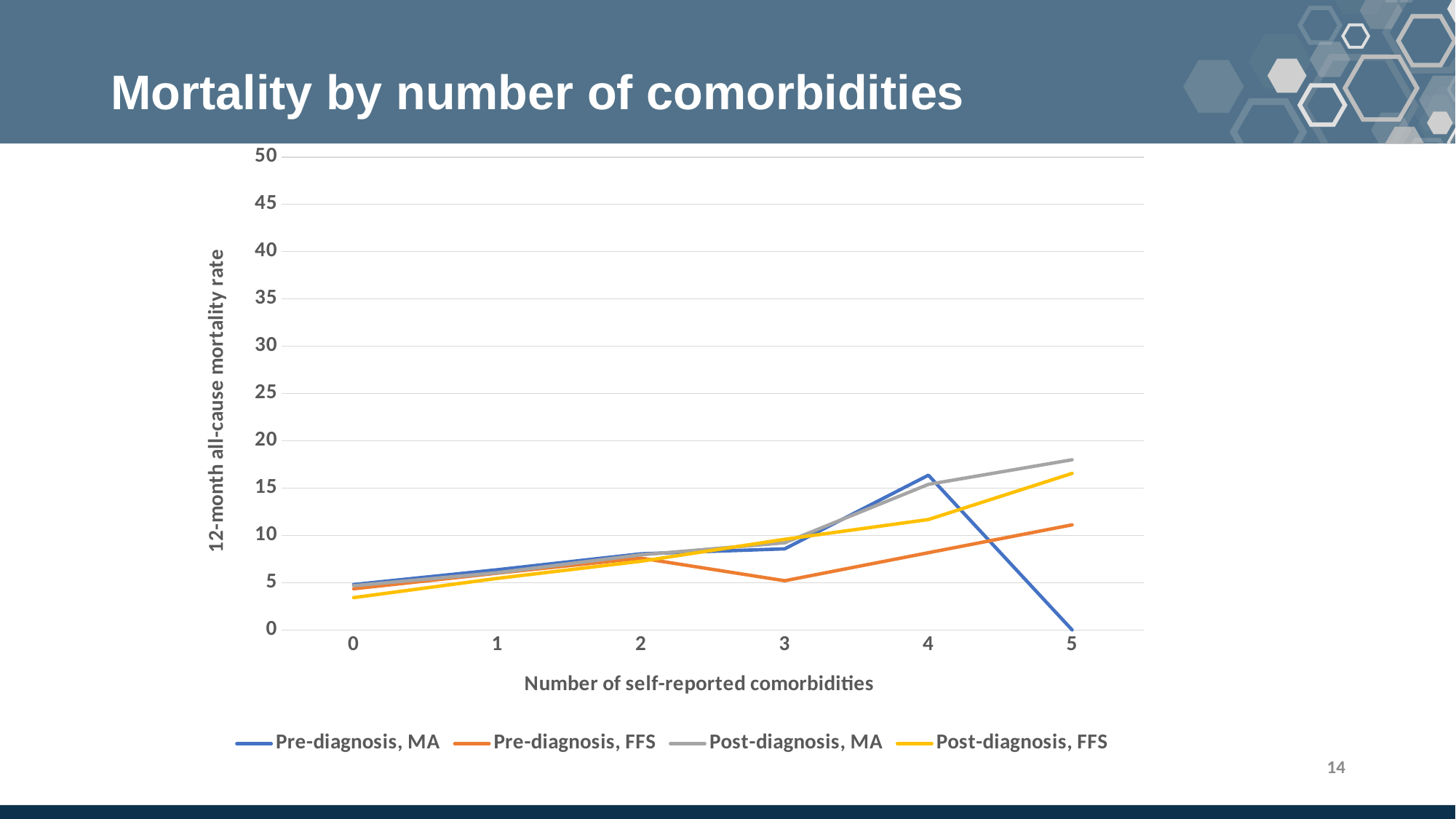
What is the value for Pre-diagnosis, MA at 5 comorbidities? 0 Is the value for Post-diagnosis, MA at 5 comorbidities greater or less than 15? greater At 4 comorbidities, which is larger: Pre-diagnosis, MA or Pre-diagnosis, FFS? Pre-diagnosis, MA How many values of number of self-reported comorbidities are shown on the x axis? 6 Which series has the highest value at 5 comorbidities? Post-diagnosis, MA What kind of chart is shown on the slide? line chart Which series has the lowest value at 5 comorbidities? Pre-diagnosis, MA Is the value for Pre-diagnosis, FFS at 5 comorbidities greater or less than 15? less Does the Post-diagnosis, FFS line rise or fall as the number of comorbidities increases from 0 to 5? rise How many series does the legend list? 4 Is the value for Post-diagnosis, FFS at 0 comorbidities greater or less than 5? less What is the title of the y axis? 12-month all-cause mortality rate